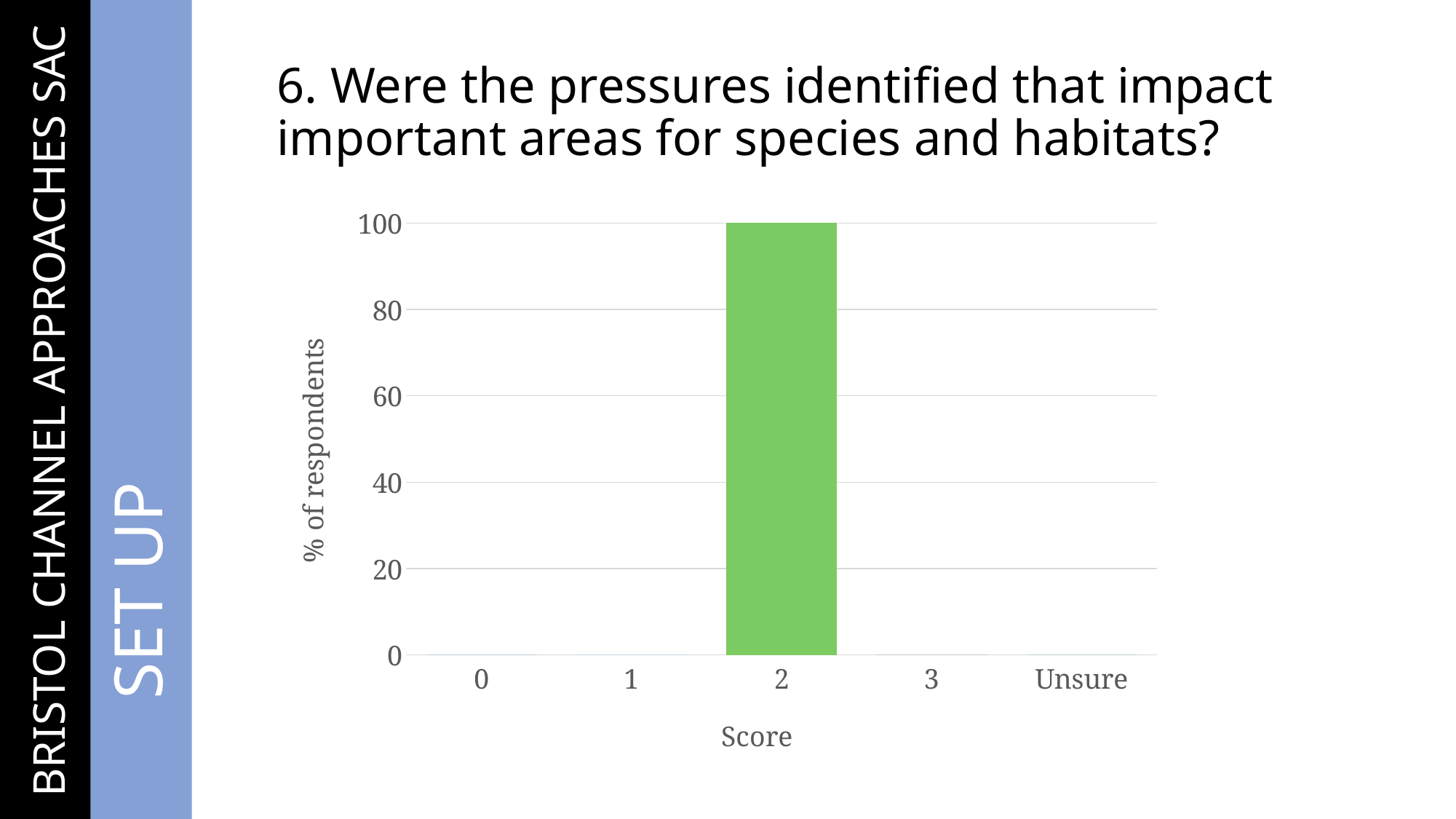
What is the label of the y axis? % of respondents What is the % of respondents for score 3? 0 What is the difference between the % of respondents for score 2 and score 1? 100 Which score category has the highest % of respondents? 2 Is the value for score 2 greater or less than 80? greater What is the label of the x axis? Score What is the % of respondents for score 2? 100 What kind of chart is shown on the slide? bar chart What is the % of respondents for the Unsure category? 0 How many categories are shown on the x axis? 5 What is the % of respondents for score 0? 0 Which is larger, the value for score 2 or the value for score 3? score 2